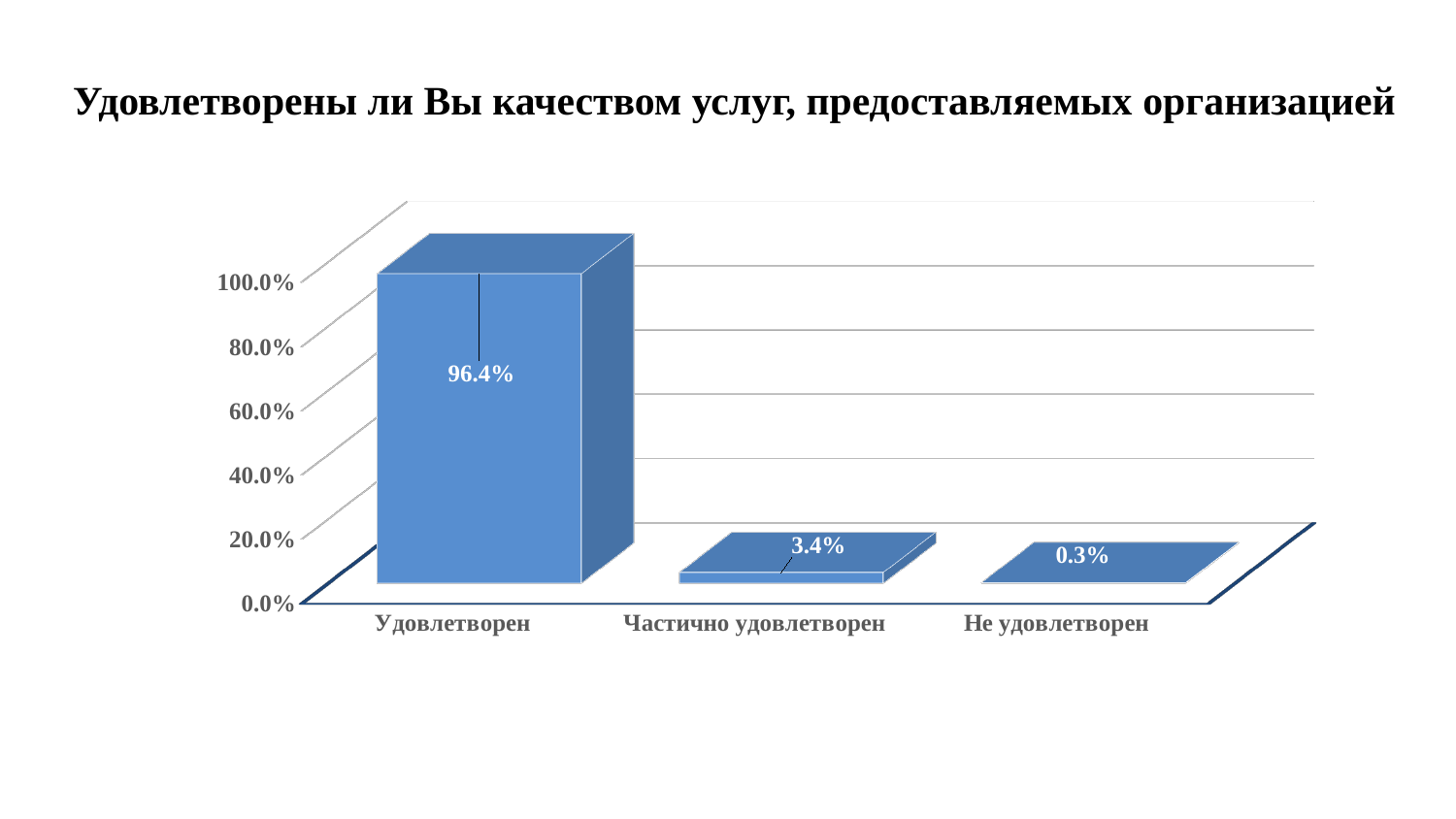
What is the title of the chart? Удовлетворены ли Вы качеством услуг, предоставляемых организацией Which is larger, the value for Частично удовлетворен or the value for Не удовлетворен? Частично удовлетворен What is the value for Частично удовлетворен? 3.4% How many categories are shown on the x axis? 3 What is the difference between the values for Частично удовлетворен and Не удовлетворен? 3.1% What is the value for Удовлетворен? 96.4% Which category has the lowest value? Не удовлетворен What is the value for Не удовлетворен? 0.3% Is the value for Удовлетворен greater or less than 80.0%? greater What kind of chart is shown on the slide? bar chart What is the difference between the values for Удовлетворен and Частично удовлетворен? 93.0% Which category has the highest value? Удовлетворен